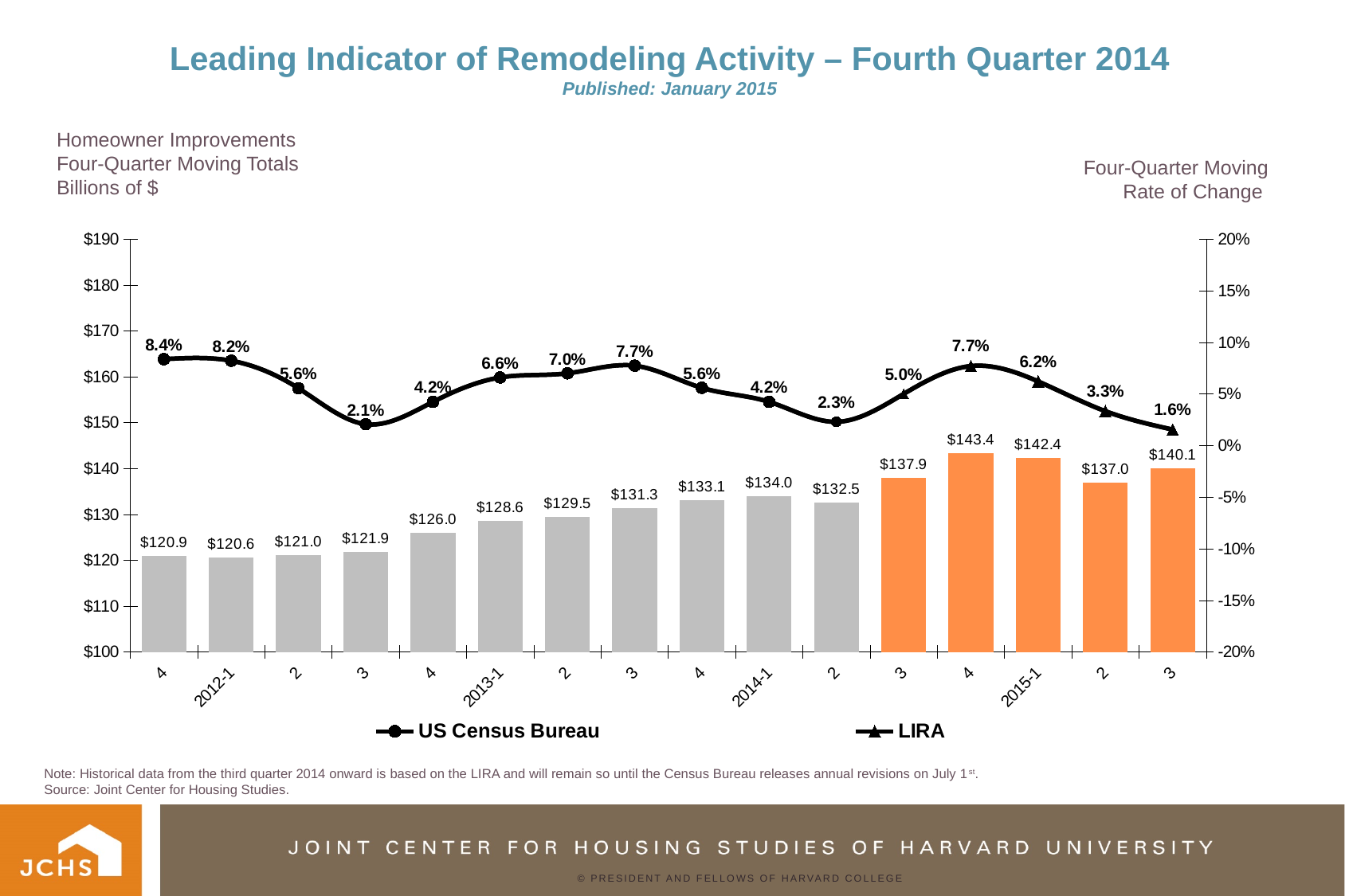
Which is larger, the four-quarter moving total for 2013 quarter 4 ($133.1) or 2014 quarter 2 ($132.5)? 2013 quarter 4 What is the four-quarter moving rate of change for the third quarter of 2013 (labeled 3 after 2013-1)? 7.7% What kind of chart is shown on the slide? Combination bar and line chart Which quarter has the highest four-quarter moving total bar? 2014 quarter 4 ($143.4) Which quarter has the lowest four-quarter moving total bar? 2012-1 ($120.6) How many bars (quarters) are plotted in the chart? 16 Does the rate of change line rise or fall from 2014 quarter 4 to 2015 quarter 3? Fall What is the highest rate of change value shown on the line? 8.4% What is the difference between the four-quarter moving totals for 2015-1 and 2014-1? $8.4 What is the four-quarter moving total for 2014-1? $134.0 How many series does the legend list? 2 Which point has the lowest four-quarter moving rate of change on the line? 2015 quarter 3 (1.6%)